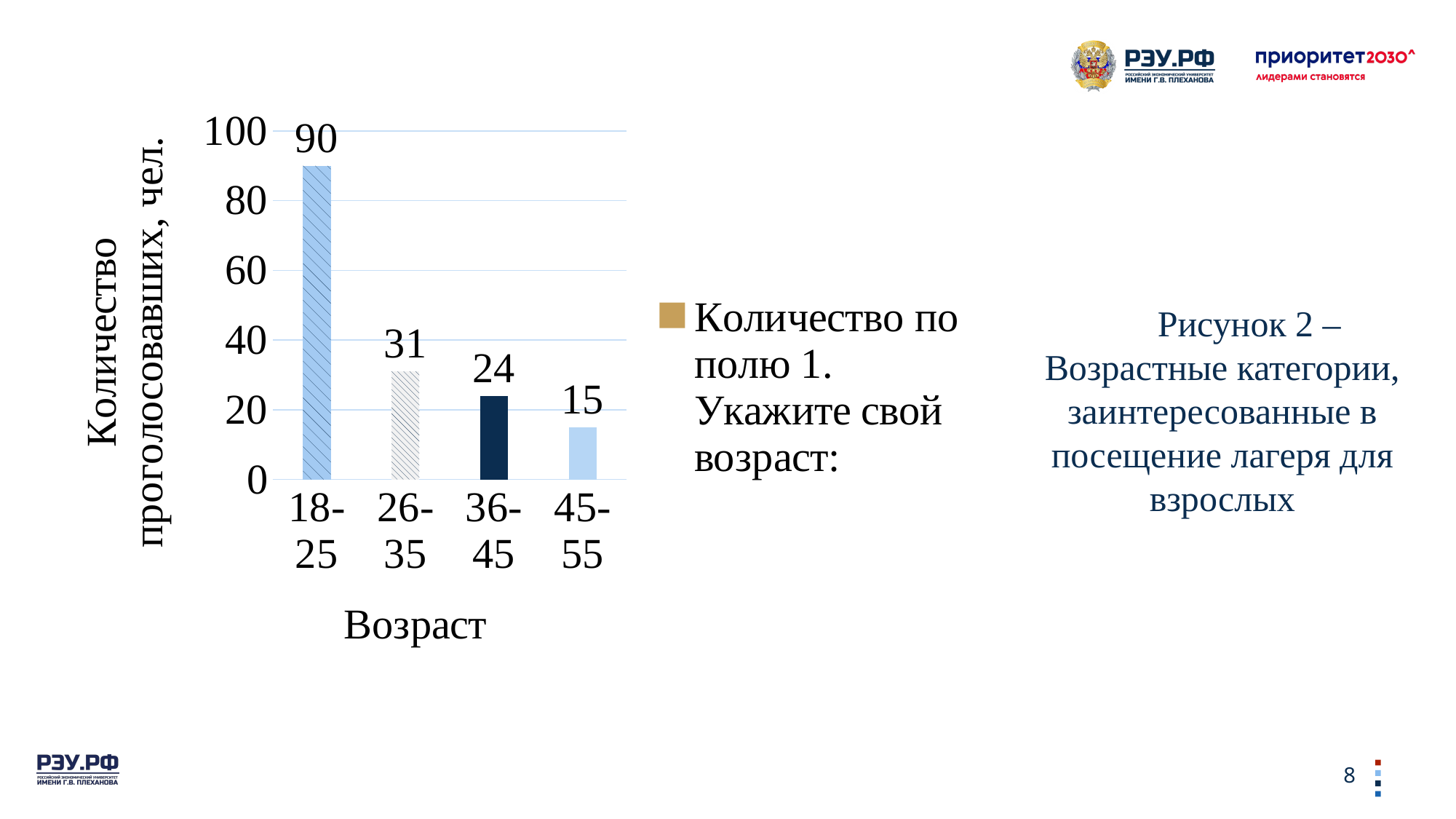
What is the difference between the values for 36-45 and 45-55? 9 What is the label of the x axis? Возраст What is the value for the 18-25 age group? 90 How many age categories are shown on the x axis? 4 Which age group has the highest value? 18-25 What kind of chart is shown on the slide? Bar chart What is the value for the 36-45 age group? 24 What is the difference between the values for 18-25 and 26-35? 59 What is the value for the 26-35 age group? 31 What is the value for the 45-55 age group? 15 Which age group has the lowest value? 45-55 Which is larger, the value for 26-35 or the value for 36-45? 26-35